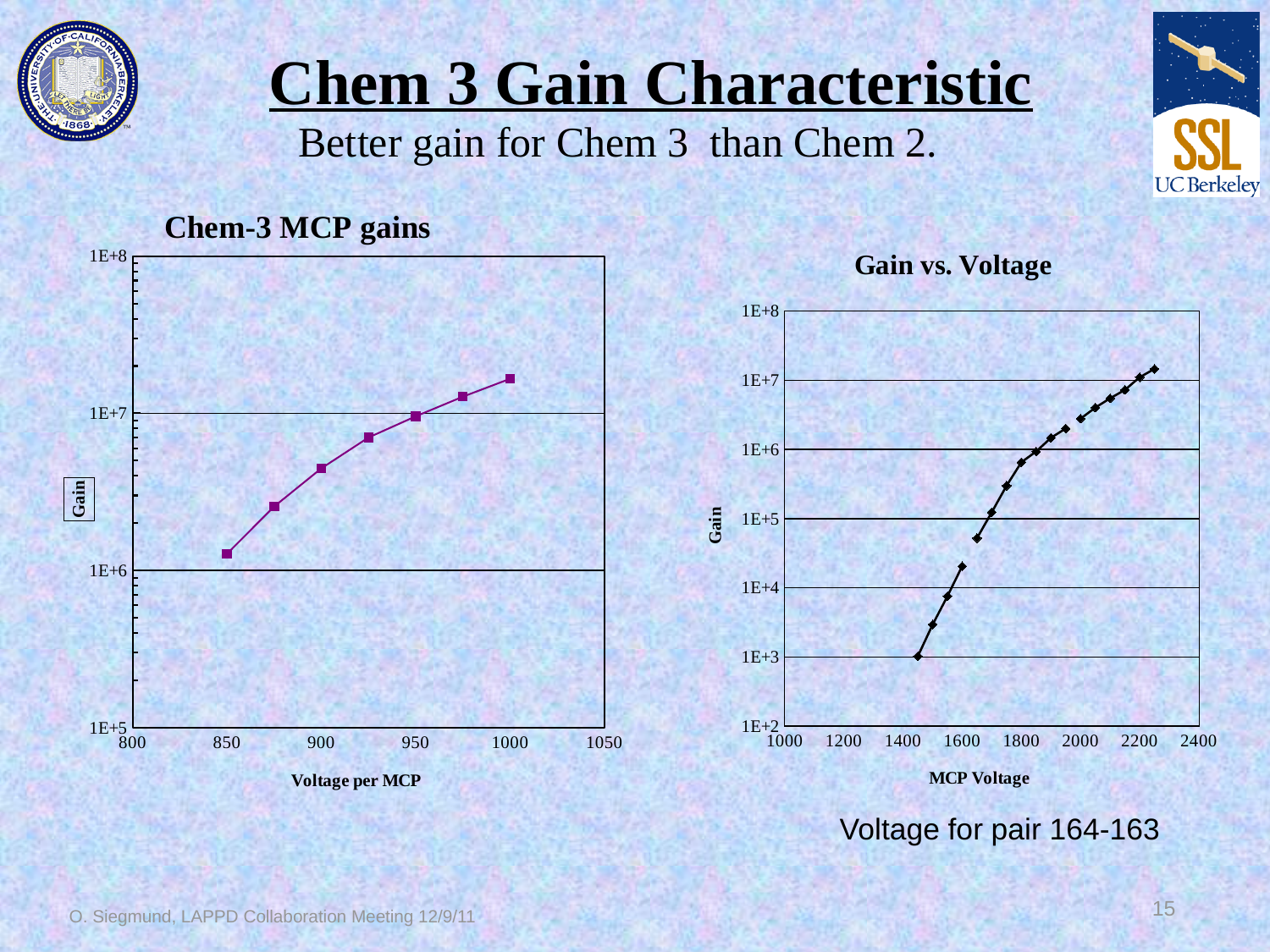
In the 'Chem-3 MCP gains' chart, is the gain at 850 V per MCP greater or less than 1E+6? greater What kind of chart is the 'Chem-3 MCP gains' chart on the left? line chart In the 'Gain vs. Voltage' chart, is the gain at 1800 V greater or less than 1E+6? less In the 'Chem-3 MCP gains' chart, is the gain at 900 V per MCP greater or less than 1E+7? less In the 'Chem-3 MCP gains' chart, what is the x-axis title? Voltage per MCP In the 'Gain vs. Voltage' chart, what is the x-axis title? MCP Voltage In the 'Gain vs. Voltage' chart on the right, does the gain rise or fall as MCP voltage increases? rise In the 'Chem-3 MCP gains' chart, which plotted voltage has the highest gain? 1000 In the 'Chem-3 MCP gains' chart, how many data points are plotted? 7 In the 'Chem-3 MCP gains' chart, does the gain rise or fall as voltage per MCP increases? rise